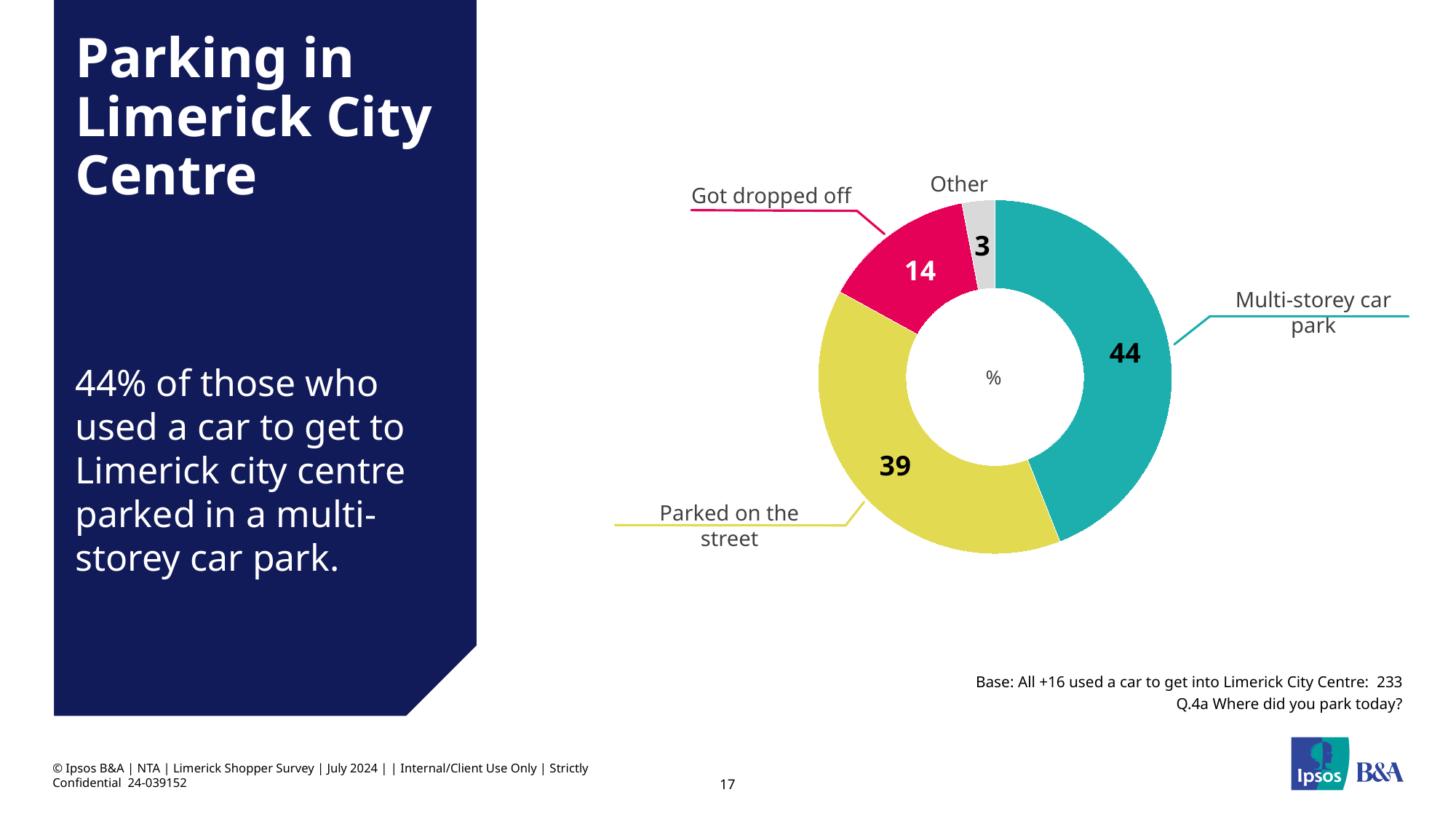
What colour is the Parked on the street segment? Yellow What is the value for Other? 3 What is the value for Multi-storey car park? 44 Which is larger, the value for Got dropped off or the value for Other? Got dropped off What kind of chart is shown on the slide? Doughnut (pie) chart What is the difference between the values for Multi-storey car park and Parked on the street? 5 How many categories does the chart show? 4 What is the value for Parked on the street? 39 Which category has the highest value? Multi-storey car park What is the difference between the values for Got dropped off and Other? 11 Which category has the lowest value? Other What is the value for Got dropped off? 14